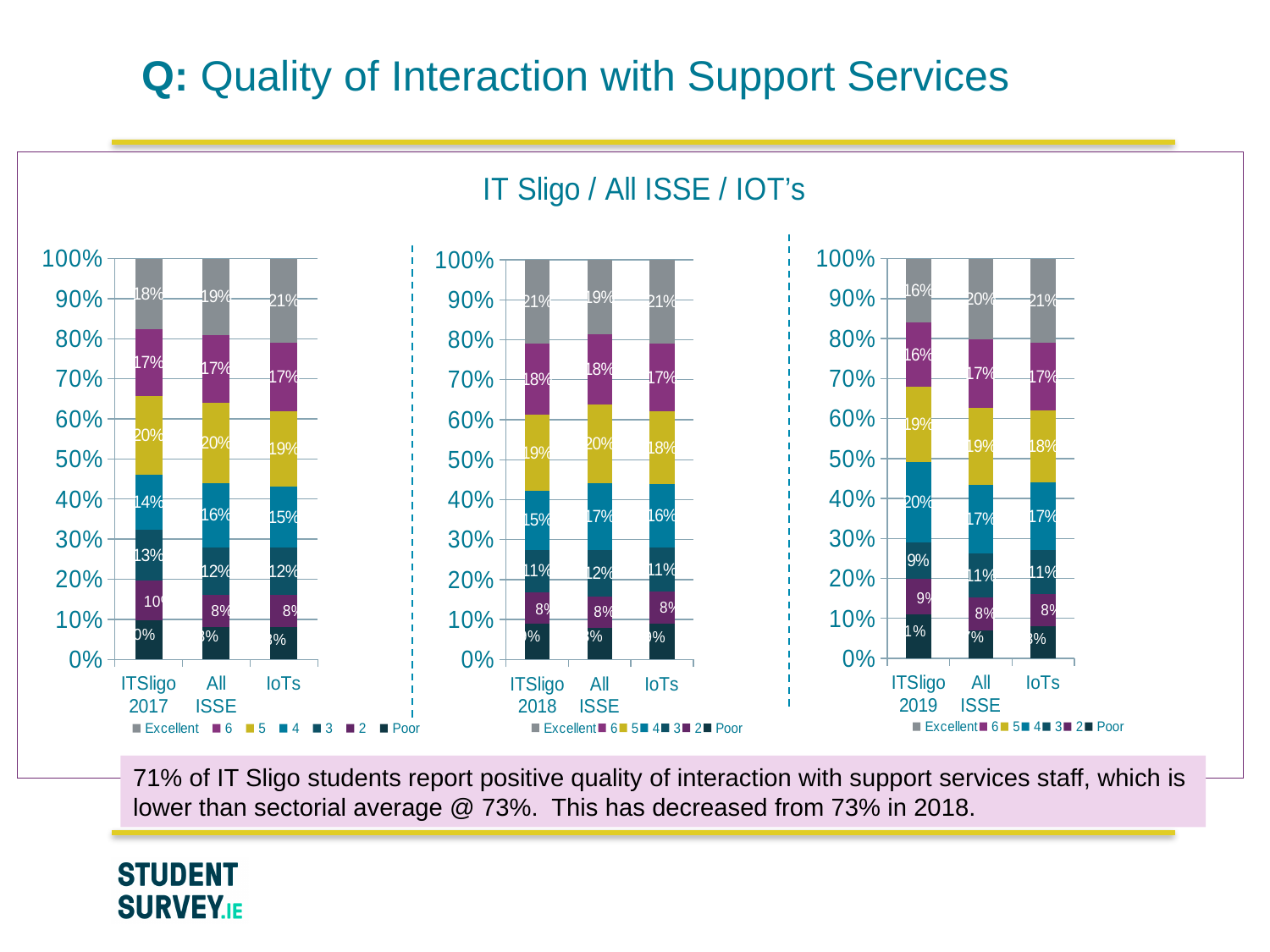
In the right chart (2019), what is the value of the '4' segment for ITSligo 2019? 20% What kind of chart is used on this slide? Stacked bar chart In the right chart (2019), what is the difference between the 'Excellent' value for IoTs and for ITSligo 2019? 5 percentage points In the right chart (2019), what is the 'Excellent' value for All ISSE? 20% In the left chart (2017), what percentage of ITSligo 2017 responses are 'Excellent'? 18% In the middle chart (2018), what is the value of the '5' segment for All ISSE? 20% In the left chart (2017), which has the larger '3' segment: ITSligo 2017 or All ISSE? ITSligo 2017 In the middle chart (2018), what percentage of ITSligo 2018 responses are 'Excellent'? 21% What is the title shown above the three charts? IT Sligo / All ISSE / IOT's How many categories (bars) are shown in the left chart (2017)? 3 In the right chart (2019), which category has the highest 'Excellent' value? IoTs How many series does the legend of each chart list? 7